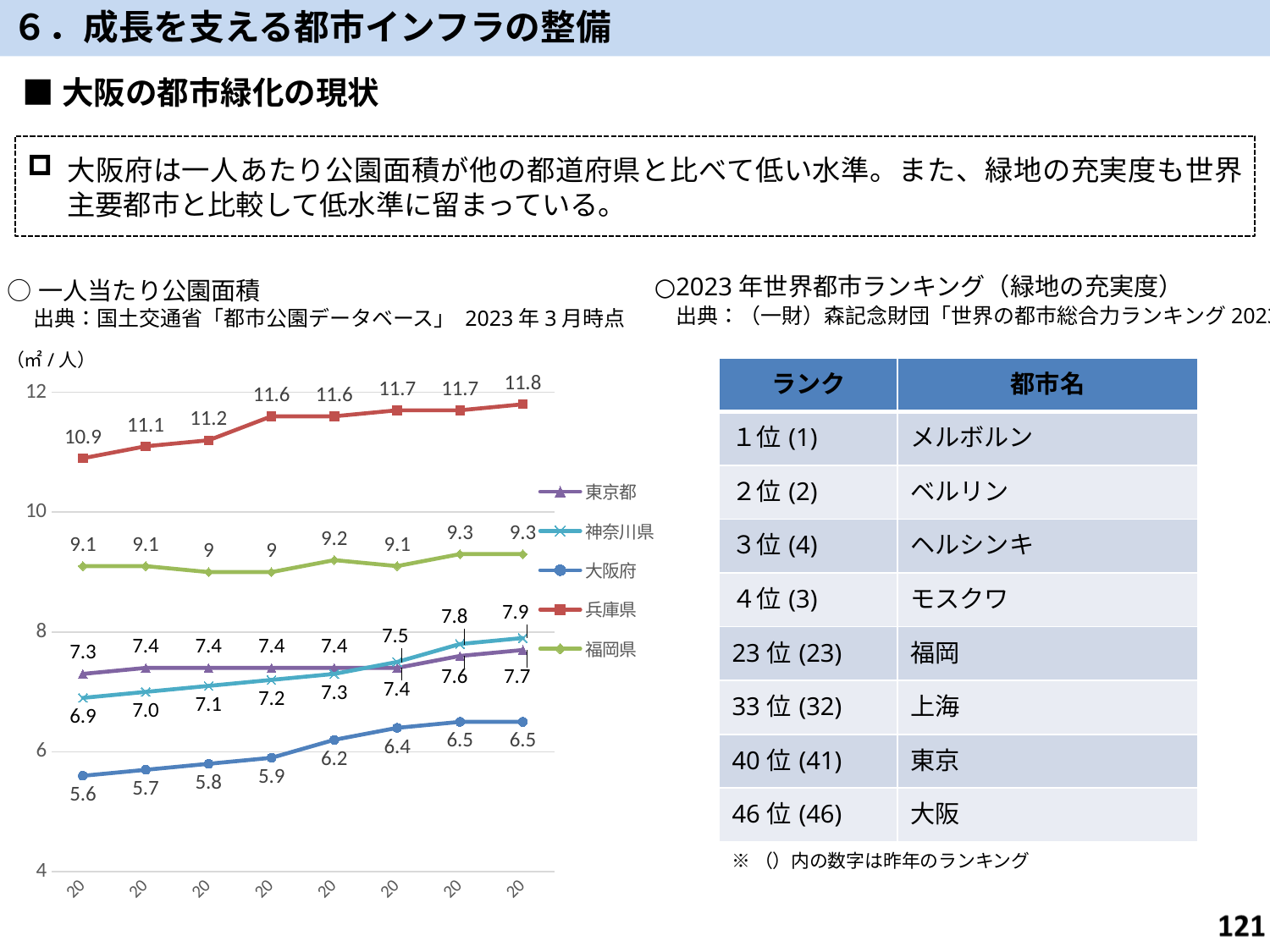
In the 一人当たり公園面積 chart, which prefecture has the highest value at the last point? 兵庫県 In the 一人当たり公園面積 chart, what is the value of 神奈川県 at the last point? 7.9 In the 一人当たり公園面積 chart, which is larger at the last point: 神奈川県 or 東京都? 神奈川県 How many data points does each line in the 一人当たり公園面積 chart have? 8 In the 一人当たり公園面積 chart, what is the value of 大阪府 at the first point? 5.6 In the 一人当たり公園面積 chart, what is the value of 兵庫県 at the last point? 11.8 In the 一人当たり公園面積 chart, which prefecture has the lowest value at the last point? 大阪府 What unit is shown on the y axis of the 一人当たり公園面積 chart? ㎡/人 What kind of chart is the 一人当たり公園面積 chart? line chart How many series does the legend of the 一人当たり公園面積 chart list? 5 In the 一人当たり公園面積 chart, does the 大阪府 line generally rise or fall from left to right? rise In the 一人当たり公園面積 chart, what is the difference between 兵庫県 (11.8) and 大阪府 (6.5) at the last point? 5.3